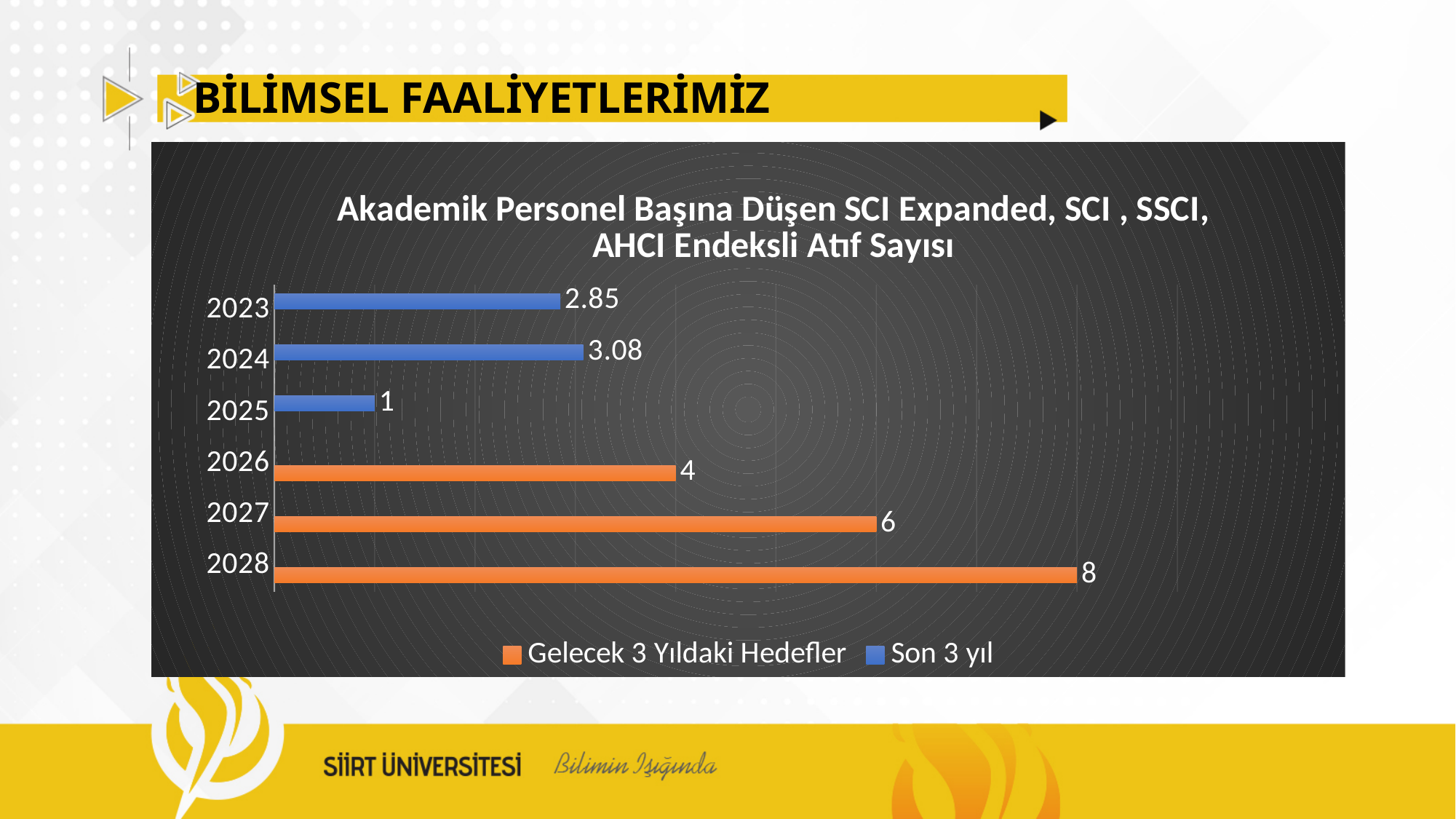
What is the value for 2024? 3.08 What is the value for 2027? 6 Which year has the lowest value? 2025 How many years are shown on the chart? 6 What is the value for 2023? 2.85 Which year has the highest value? 2028 Which series is shown in orange? Gelecek 3 Yıldaki Hedefler Which is larger, the value for 2024 or the value for 2023? 2024 How many series does the legend list? 2 What is the difference between the values for 2028 and 2026? 4 What is the value for 2025? 1 What kind of chart is shown? Bar chart